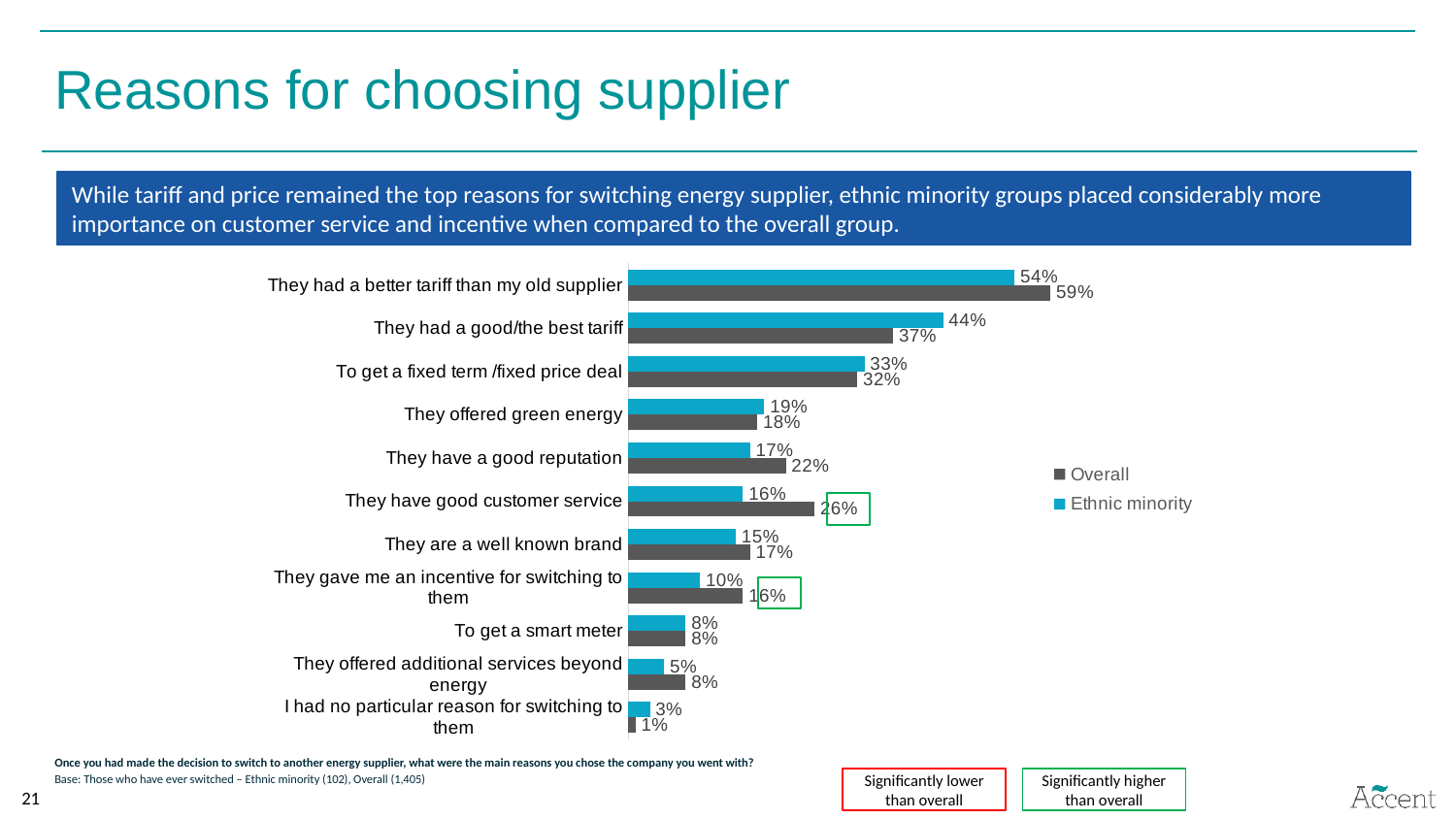
What is the difference between the Overall and Ethnic minority values for 'They had a better tariff than my old supplier'? 5 percentage points What kind of chart is shown on the slide? Bar chart What is the difference between the Ethnic minority and Overall values for 'They had a good/the best tariff'? 7 percentage points Which reason has the highest Overall value? They had a better tariff than my old supplier For 'To get a smart meter', what value is shown for both Overall and Ethnic minority? 8% What is the Overall value for 'They have a good reputation'? 22% How many reasons (categories) are plotted in the chart? 11 How many series does the legend list? 2 What is the Overall value for 'They had a better tariff than my old supplier'? 59% Which reason has the lowest Overall value? I had no particular reason for switching to them What are the two series named in the legend? Overall and Ethnic minority What is the Ethnic minority value for 'They had a good/the best tariff'? 44%